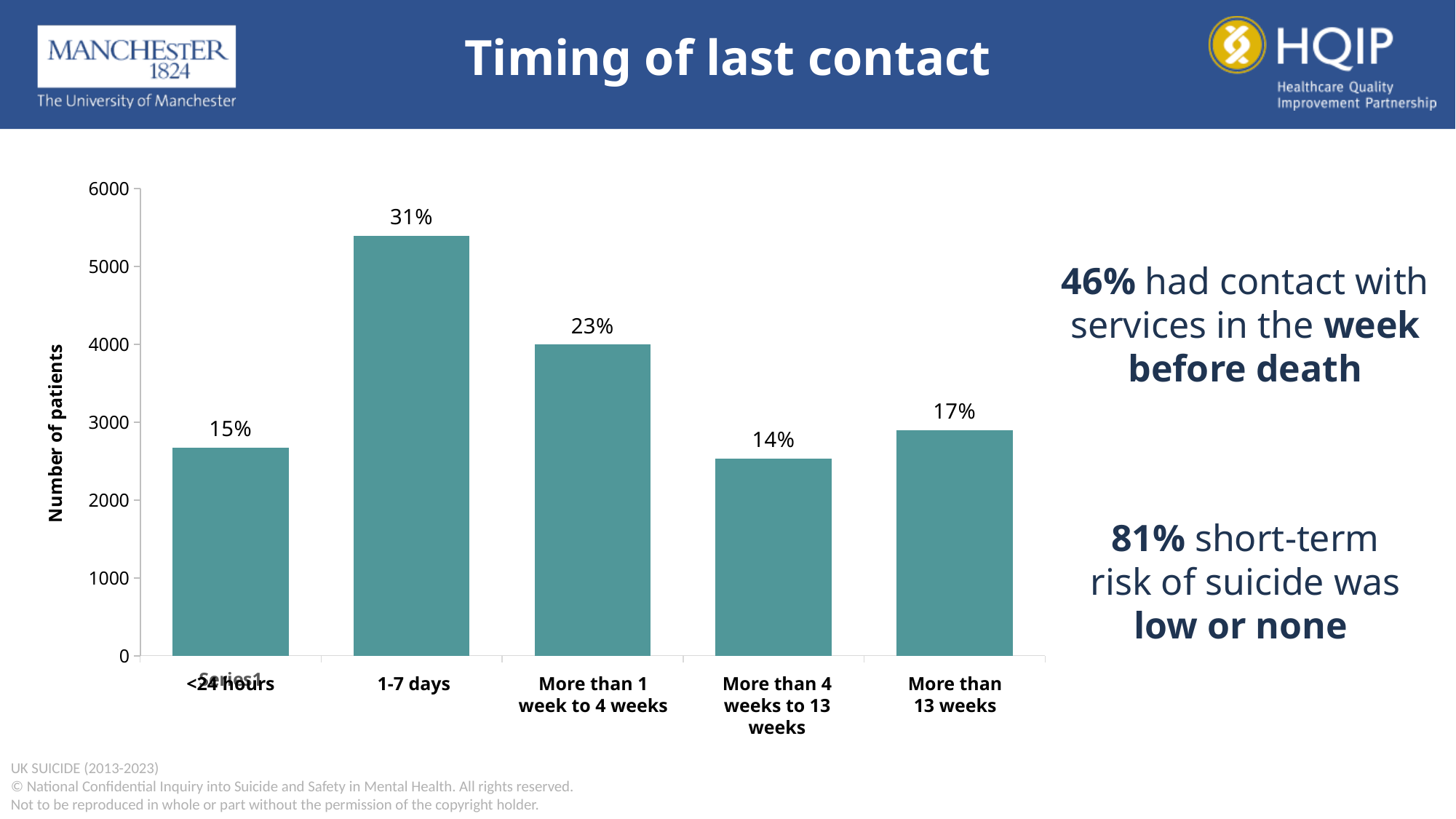
What percentage is shown for the More than 1 week to 4 weeks category? 23% What percentage is shown for the More than 13 weeks category? 17% What percentage is shown for the 1-7 days category? 31% What percentage is shown for the <24 hours category? 15% Which is larger, the value for More than 13 weeks or the value for More than 4 weeks to 13 weeks? More than 13 weeks Is the number of patients for <24 hours greater or less than 3000? less What kind of chart is shown on the slide? bar chart Is the number of patients for 1-7 days greater or less than 5000? greater Which category has the lowest value? More than 4 weeks to 13 weeks Which category has the highest value? 1-7 days How many categories are shown on the x axis? 5 What is the difference in percentage points between the 1-7 days and <24 hours categories? 16 percentage points